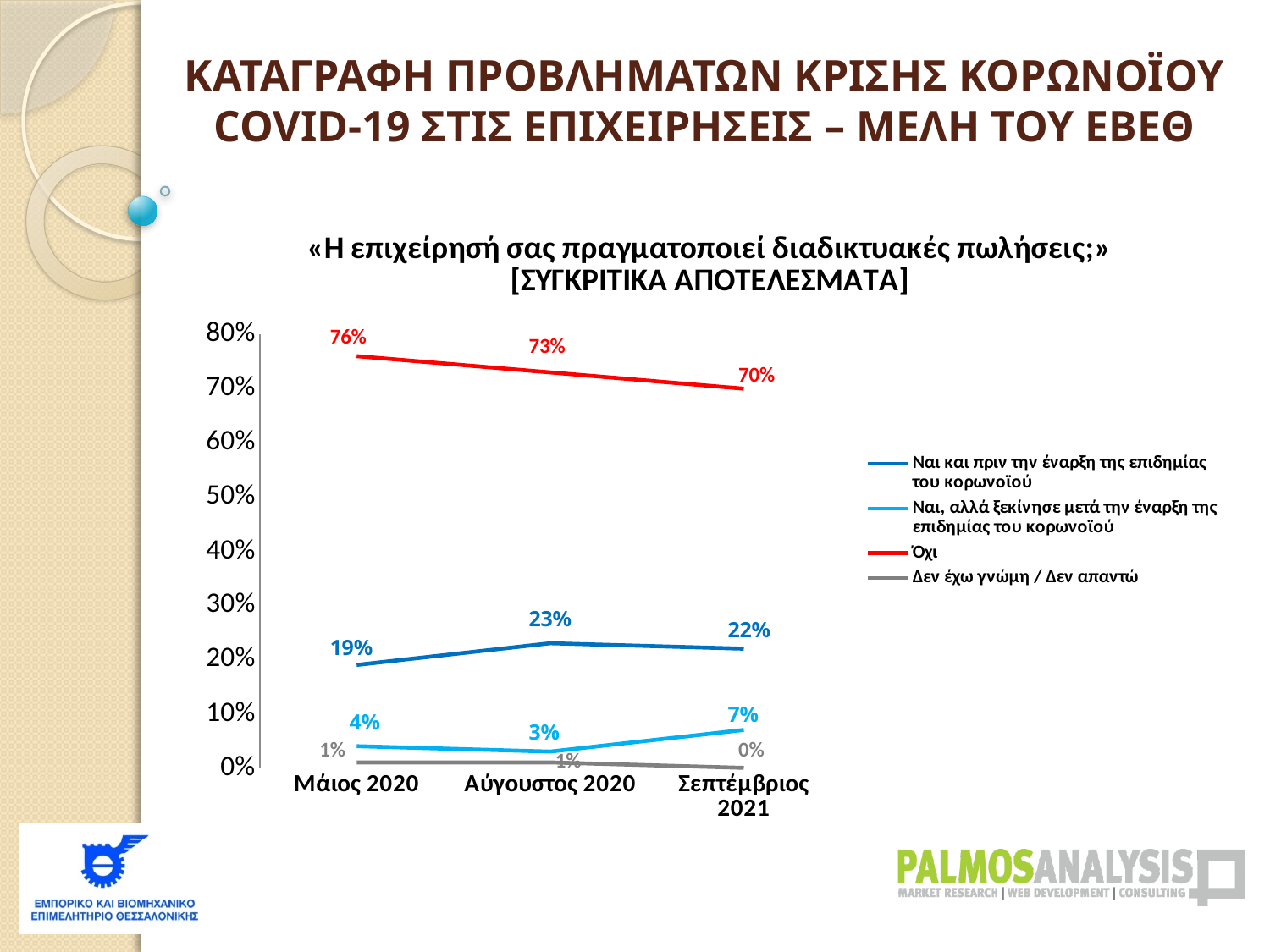
What is the value of the 'Όχι' series for Σεπτέμβριος 2021? 70% Which series has the highest value at Αύγουστος 2020? Όχι Which is larger for the 'Ναι, αλλά ξεκίνησε μετά την έναρξη της επιδημίας του κορωνοϊού' series: Αύγουστος 2020 or Σεπτέμβριος 2021? Σεπτέμβριος 2021 Does the 'Όχι' series rise or fall from Μάιος 2020 to Σεπτέμβριος 2021? Fall How many series does the legend list? 4 What is the difference between the 'Όχι' values for Μάιος 2020 and Σεπτέμβριος 2021? 6% How many time points are shown on the x axis? 3 What is the value of the 'Ναι και πριν την έναρξη της επιδημίας του κορωνοϊού' series for Αύγουστος 2020? 23% What type of chart is shown on the slide? Line chart What is the value of the 'Ναι, αλλά ξεκίνησε μετά την έναρξη της επιδημίας του κορωνοϊού' series for Σεπτέμβριος 2021? 7% What colour is the line for the 'Όχι' series? Red What is the value of the 'Όχι' series for Μάιος 2020? 76%